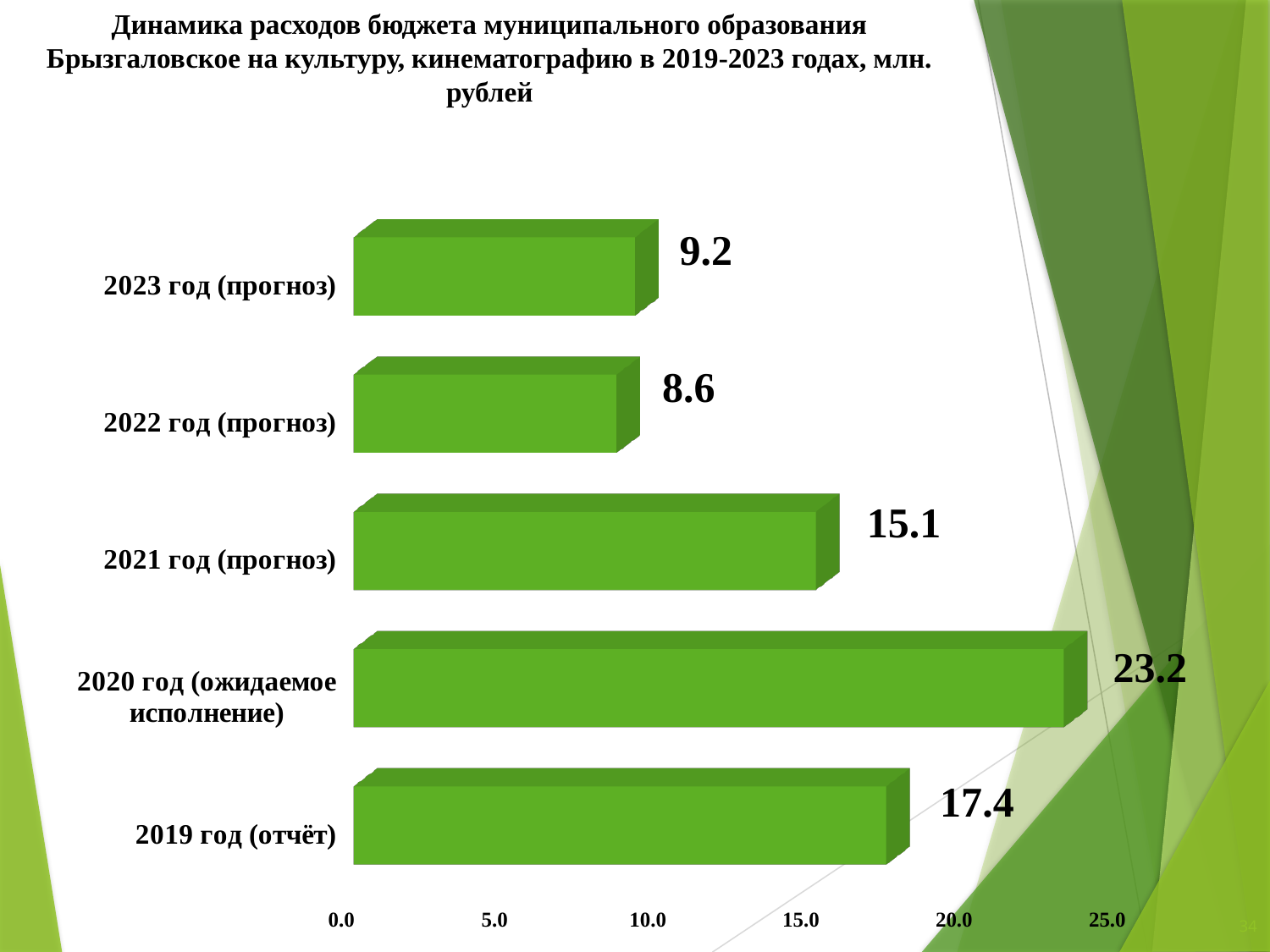
What is the value for 2020 год (ожидаемое исполнение)? 23.2 Which category has the lowest value? 2022 год (прогноз) What is the difference between the values for 2021 год (прогноз) and 2022 год (прогноз)? 6.5 What is the value for 2019 год (отчёт)? 17.4 What is the difference between the values for 2020 год (ожидаемое исполнение) and 2019 год (отчёт)? 5.8 How many categories are shown in the chart? 5 What kind of chart is shown on the slide? bar chart Which category has the highest value? 2020 год (ожидаемое исполнение) What is the value for 2023 год (прогноз)? 9.2 Which is larger, the value for 2023 год (прогноз) or 2022 год (прогноз)? 2023 год (прогноз) Is the value for 2021 год (прогноз) greater or less than 10.0? greater What is the maximum value shown on the horizontal axis? 25.0